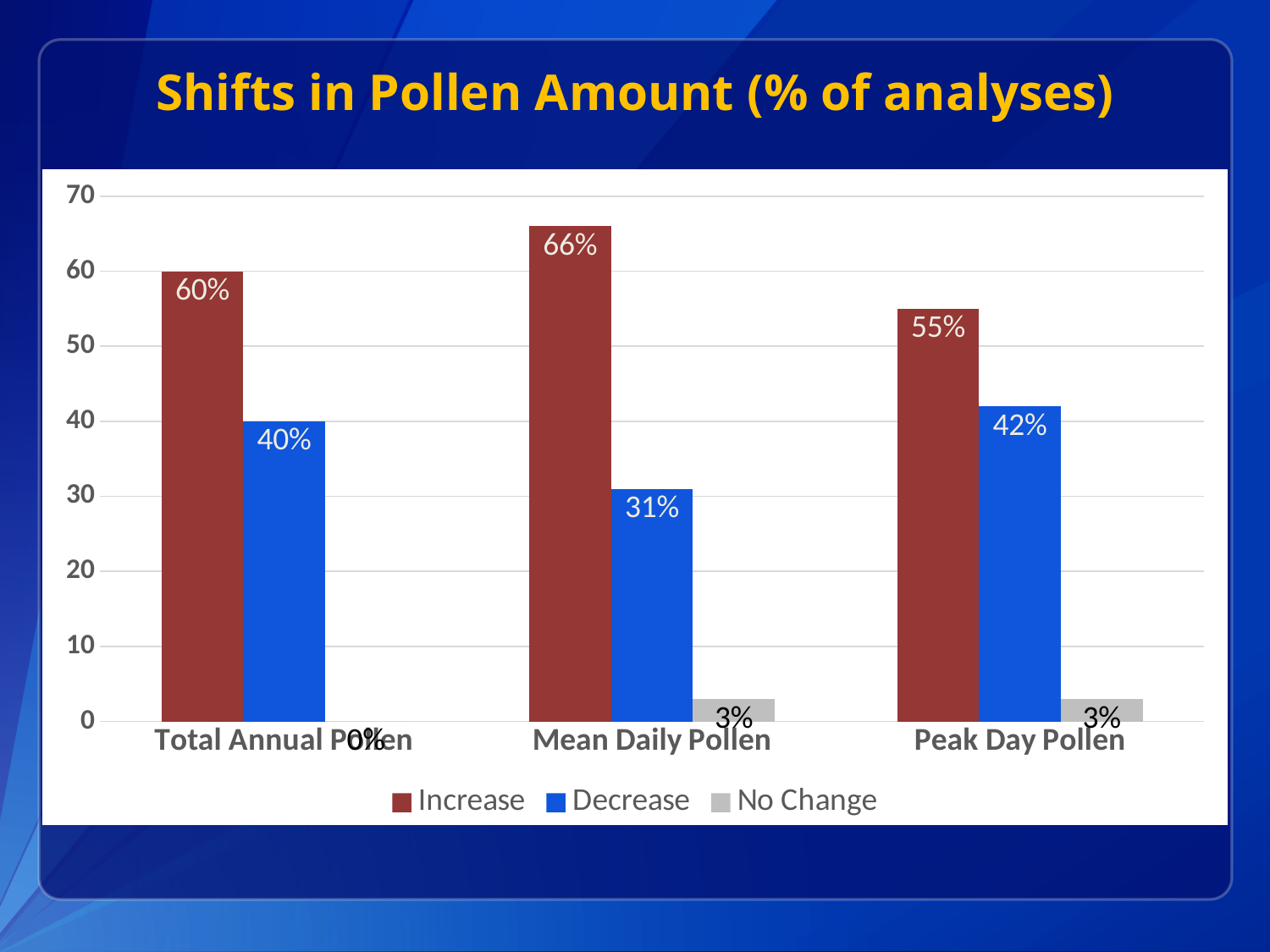
What is the Decrease value for Peak Day Pollen? 42% How many series does the legend list? 3 What is the No Change value for Total Annual Pollen? 0% Which is larger for Peak Day Pollen, the Increase value or the Decrease value? Increase What is the title of the chart? Shifts in Pollen Amount (% of analyses) What is the difference between the Increase and Decrease values for Total Annual Pollen? 20% Which category has the highest Increase value? Mean Daily Pollen What kind of chart is shown on the slide? Bar chart Which category has the lowest Decrease value? Mean Daily Pollen What is the Increase value for Mean Daily Pollen? 66% Is the Decrease value for Mean Daily Pollen greater or less than 40? less How many categories are shown on the x axis? 3